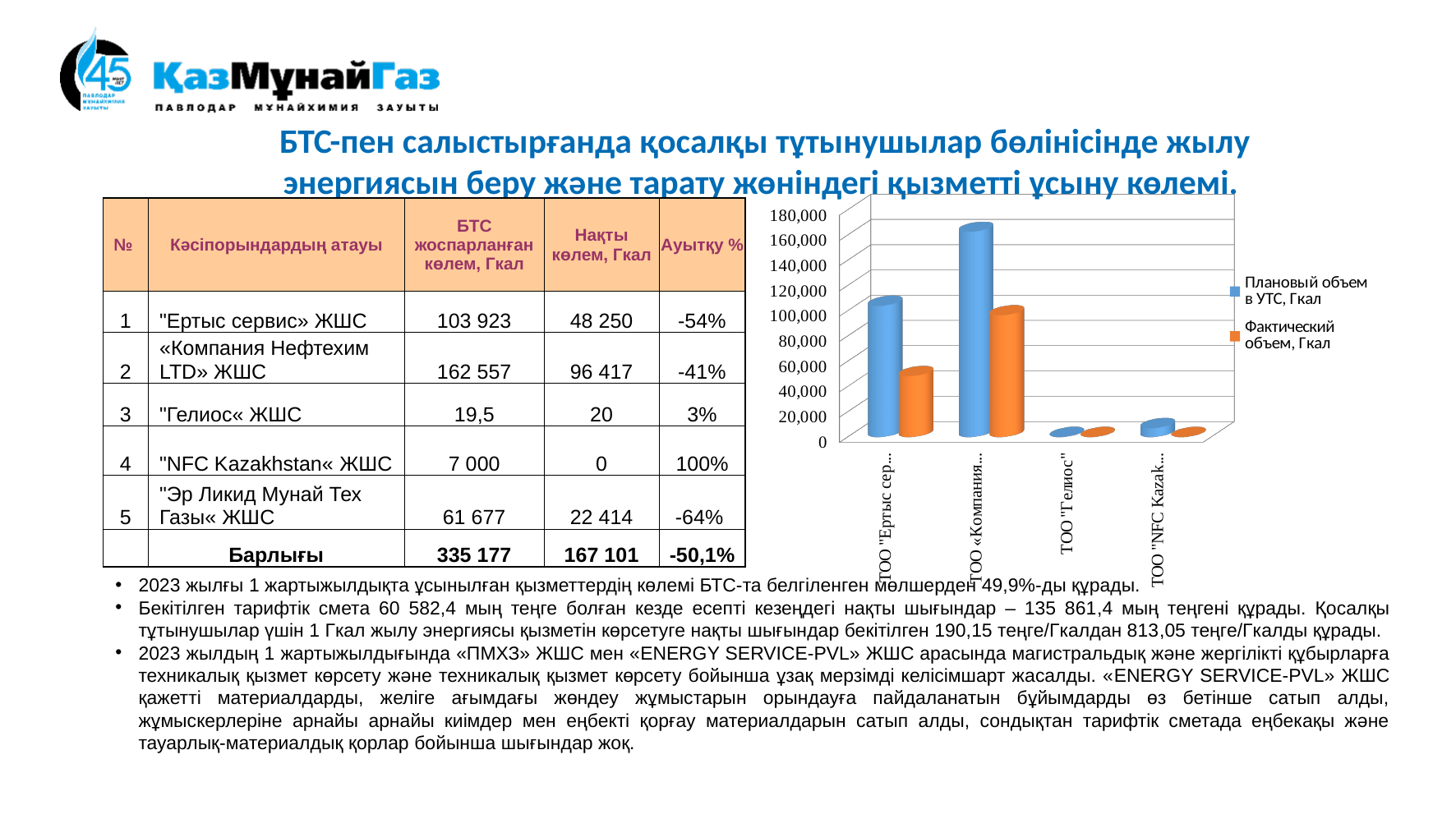
Is the "Плановый объем в УТС, Гкал" value for ТОО "Ертыс сер... greater or less than 80,000? greater Which colour represents the series "Фактический объем, Гкал" in the chart? orange What kind of chart is shown on the slide? bar chart Is the "Фактический объем, Гкал" value for ТОО "Ертыс сер... greater or less than 60,000? less Is the "Плановый объем в УТС, Гкал" value for ТОО "NFC Kazak... greater or less than 20,000? less Which category has the highest value for the series "Плановый объем в УТС, Гкал"? ТОО «Компания... How many categories are plotted along the x axis of the chart? 4 Which category has the highest value for the series "Фактический объем, Гкал"? ТОО «Компания... For ТОО "Ертыс сер..., which is larger: the "Плановый объем в УТС, Гкал" value or the "Фактический объем, Гкал" value? Плановый объем в УТС, Гкал How many series does the chart legend list? 2